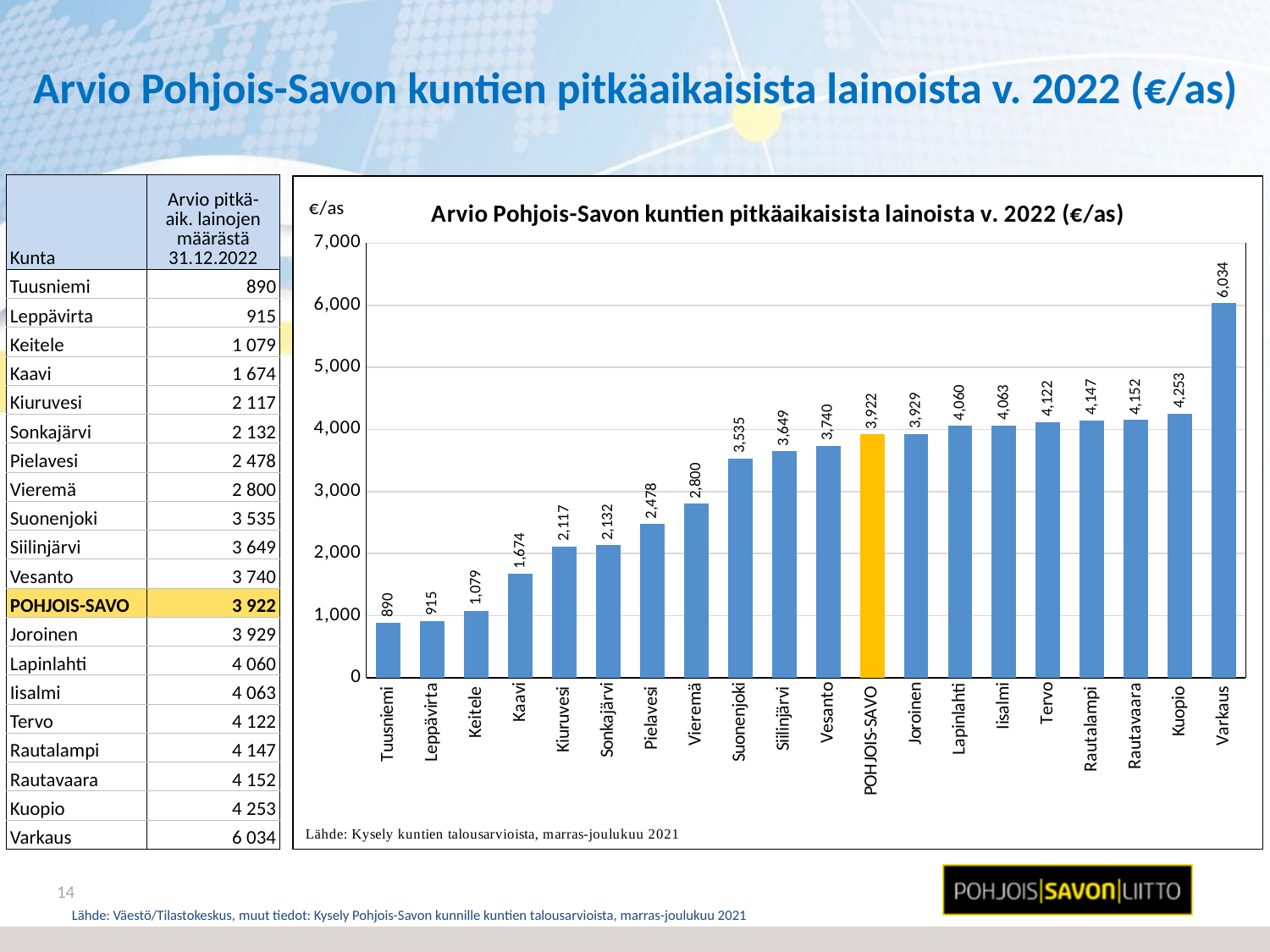
What is the difference between the values for Varkaus and Kuopio? 1,781 What is the value for POHJOIS-SAVO? 3,922 What is the value for Kiuruvesi? 2,117 How many bars are shown in the chart? 20 Which is larger, the value for Suonenjoki or the value for Vesanto? Vesanto Which bar is highlighted in a different colour (yellow) from the others? POHJOIS-SAVO What kind of chart is shown? bar chart Is the value for Vieremä greater or less than 3,000? less Which municipality has the lowest value? Tuusniemi What is the difference between the values for Kaavi and Keitele? 595 Which municipality has the highest value? Varkaus What is the value for Varkaus? 6,034